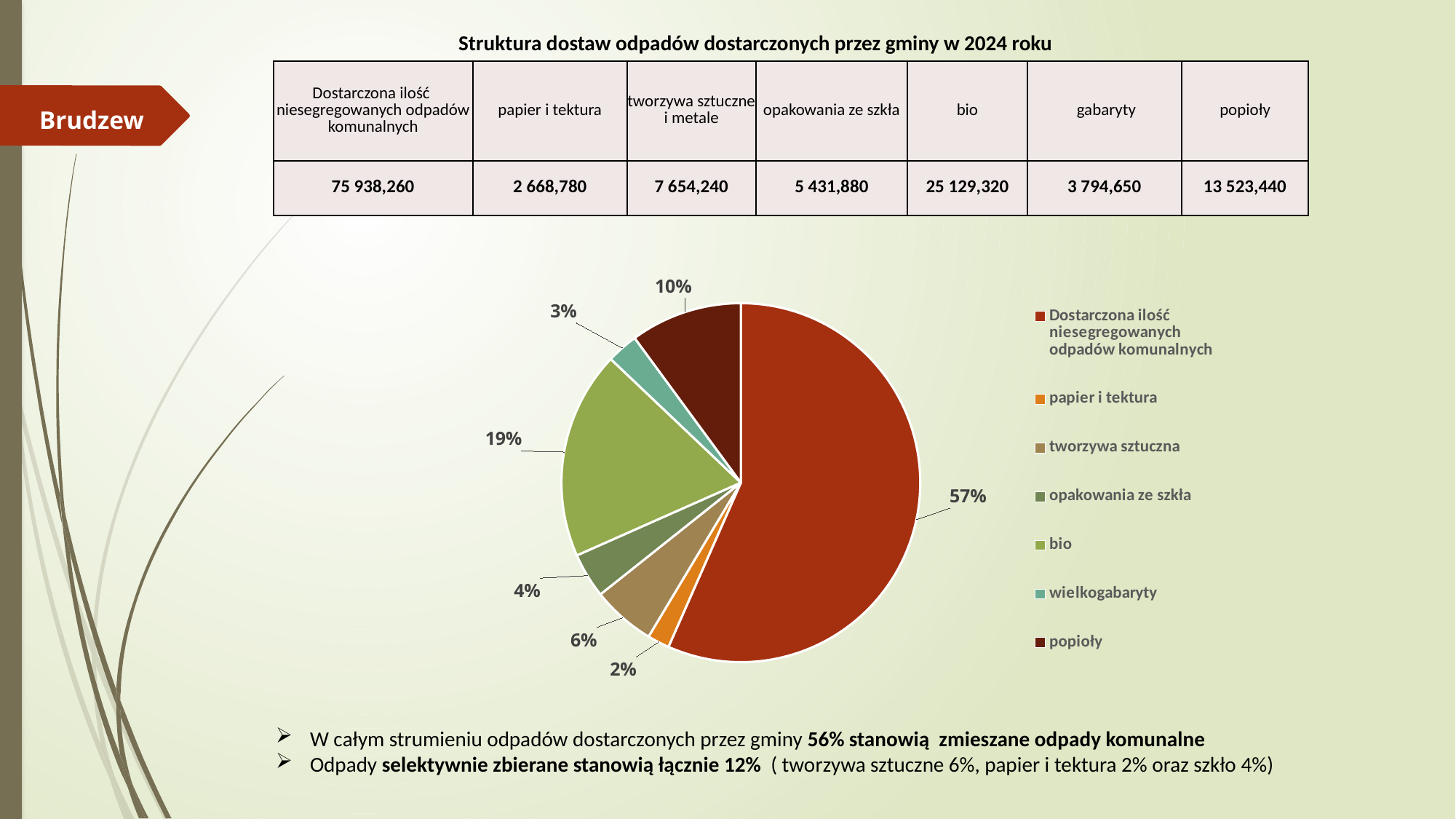
What share of the pie chart does the 'wielkogabaryty' slice represent? 3% Which category has the smallest slice in the pie chart? papier i tektura Which category has the largest slice in the pie chart? Dostarczona ilość niesegregowanych odpadów komunalnych What colour is the 'bio' slice in the pie chart? green What share of the pie chart does the 'popioły' slice represent? 10% What is the difference in percentage points between the 'bio' slice and the 'opakowania ze szkła' slice? 15% Which slice is larger in the pie chart: 'bio' or 'popioły'? bio What type of chart is shown on the slide? pie chart What share of the pie chart does the 'papier i tektura' slice represent? 2% How many slices does the pie chart have? 7